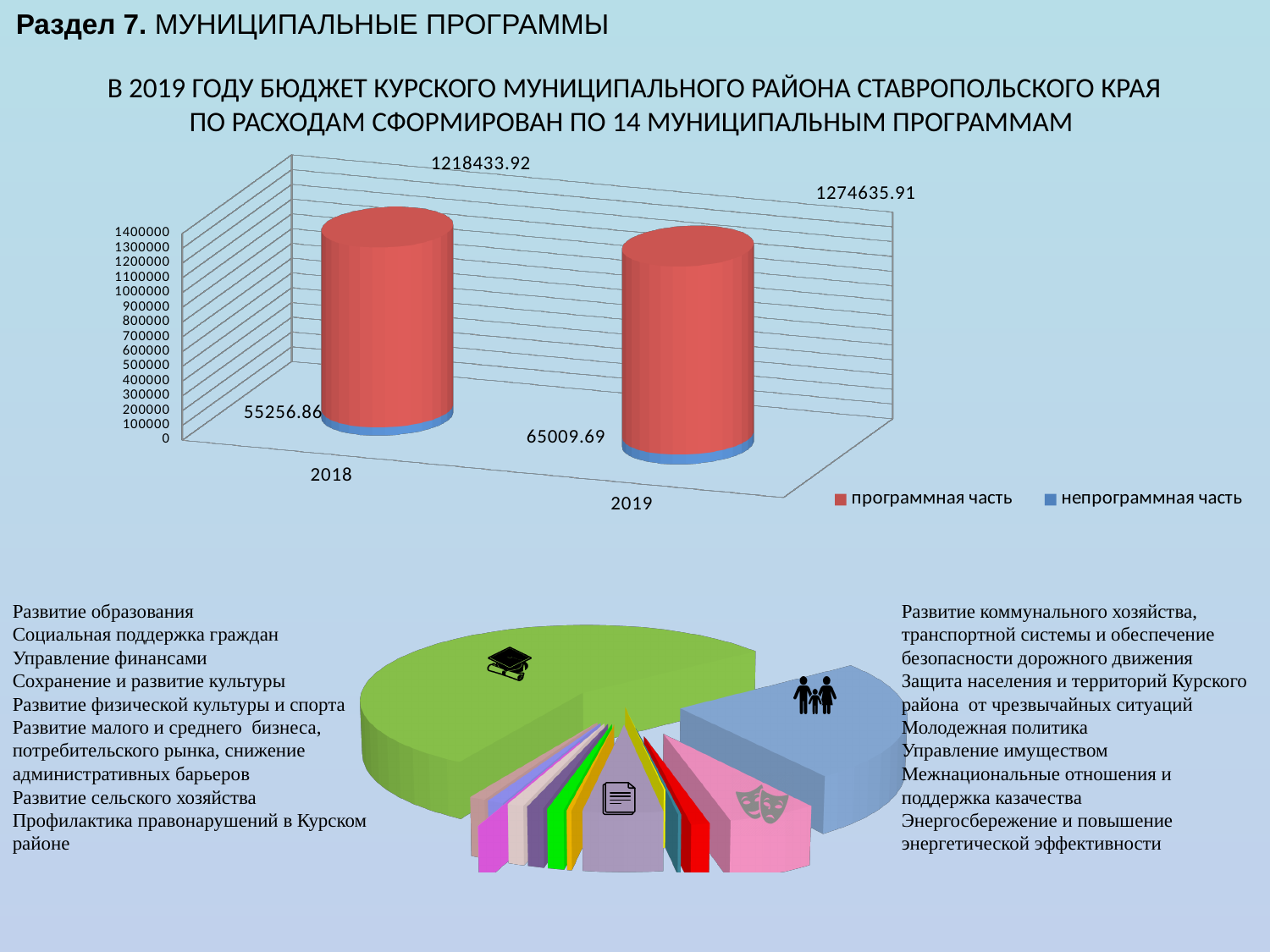
In the top bar chart, what is the value of the программная часть for 2018? 1218433.92 What kind of chart is shown at the bottom of the slide? pie chart In the top bar chart, what is the total of the stacked bar for 2018? 1273690.78 Does the непрограммная часть rise or fall from 2018 to 2019 in the top chart? rises In the top bar chart, what is the value of the непрограммная часть for 2018? 55256.86 In the top bar chart, what is the difference between the непрограммная часть values for 2019 and 2018? 9752.83 In the top bar chart, what is the value of the программная часть for 2019? 1274635.91 In the top bar chart, what is the value of the непрограммная часть for 2019? 65009.69 How many years (categories) are shown on the x axis of the top chart? 2 How many series does the legend of the top chart list? 2 In the top bar chart, which year has the larger программная часть, 2018 or 2019? 2019 In the top bar chart, by how much did the программная часть increase from 2018 to 2019? 56201.99